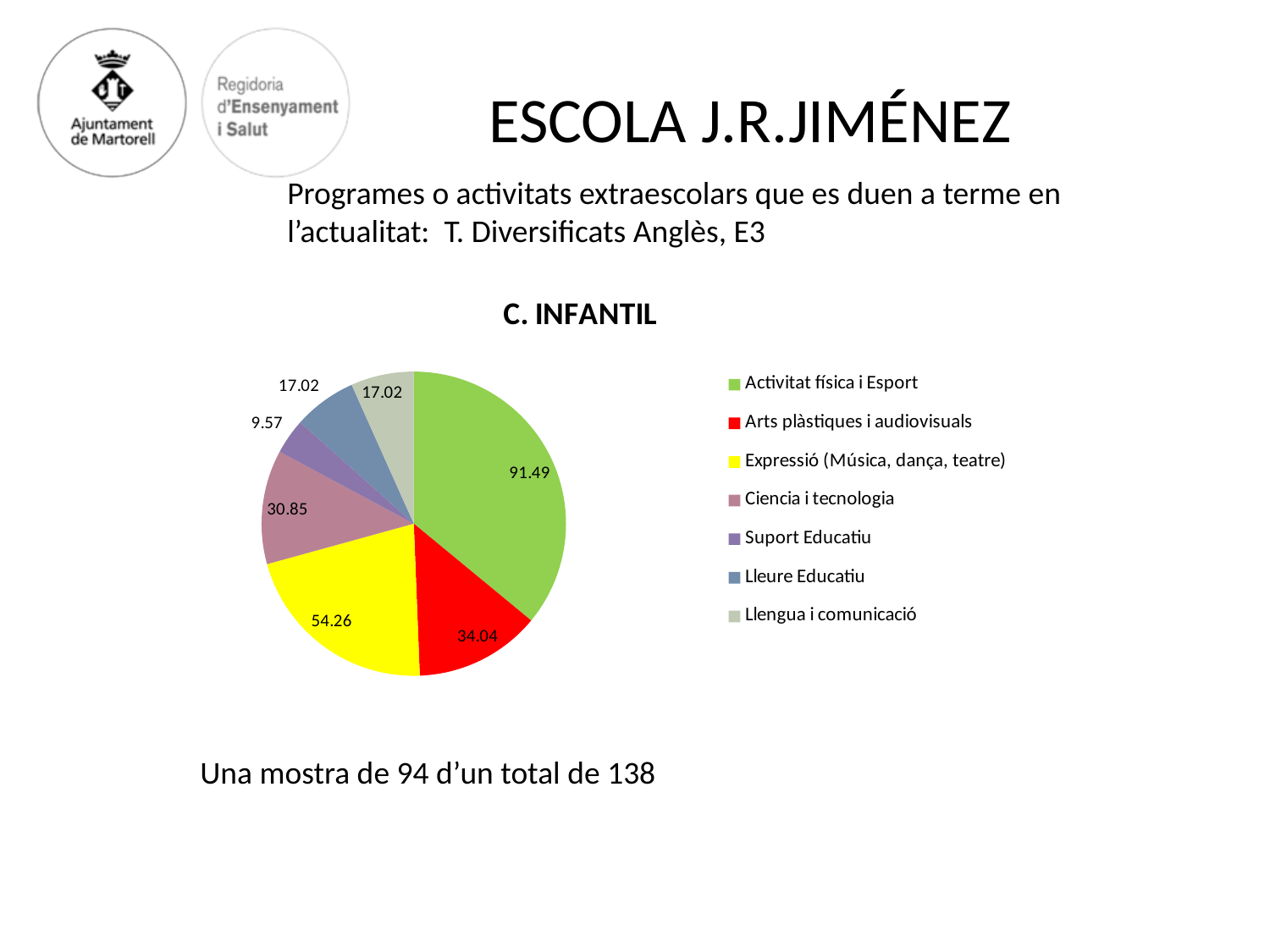
What is the value shown for Expressió (Música, dança, teatre)? 54.26 What is the value shown for Ciencia i tecnologia? 30.85 What is the value shown for Activitat física i Esport? 91.49 What is the difference between the values for Activitat física i Esport and Arts plàstiques i audiovisuals? 57.45 What type of chart is shown on the slide? pie chart What colour is the slice for Expressió (Música, dança, teatre)? yellow What is the value shown for Suport Educatiu? 9.57 How many categories does the legend of the pie chart list? 7 Which category has the smallest slice of the pie? Suport Educatiu What is the title of the chart? C. INFANTIL Which category has the largest slice of the pie? Activitat física i Esport Which is larger, the value for Expressió (Música, dança, teatre) or the value for Arts plàstiques i audiovisuals? Expressió (Música, dança, teatre)